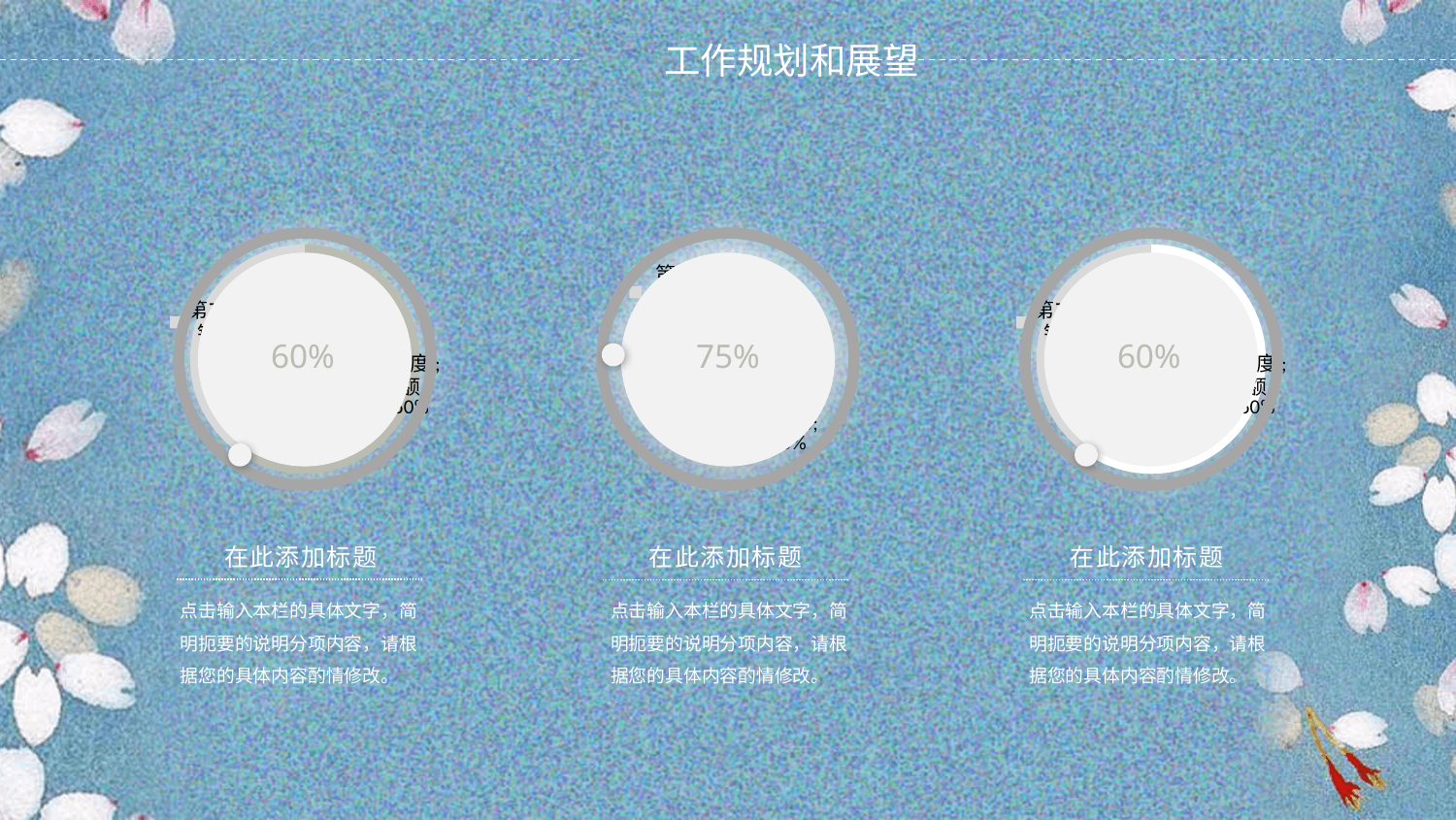
Which of the three circular charts shows the highest percentage? The middle chart (75%) Do the left and right charts show the same percentage? Yes, both show 60% How many circular progress charts are on the slide? 3 What kind of chart is used to display the percentages on this slide? Doughnut (ring) chart What heading appears below each of the three charts? 在此添加标题 What percentage is shown in the centre of the left chart? 60% What percentage is shown in the centre of the middle chart? 75% What percentage is shown in the centre of the right chart? 60% What is the difference between the percentage in the middle chart and the percentage in the right chart? 15% What is the title of the slide containing the three charts? 工作规划和展望 Is the value shown in the middle chart greater or less than 50%? greater Is the percentage in the middle chart larger or smaller than the percentage in the left chart? Larger